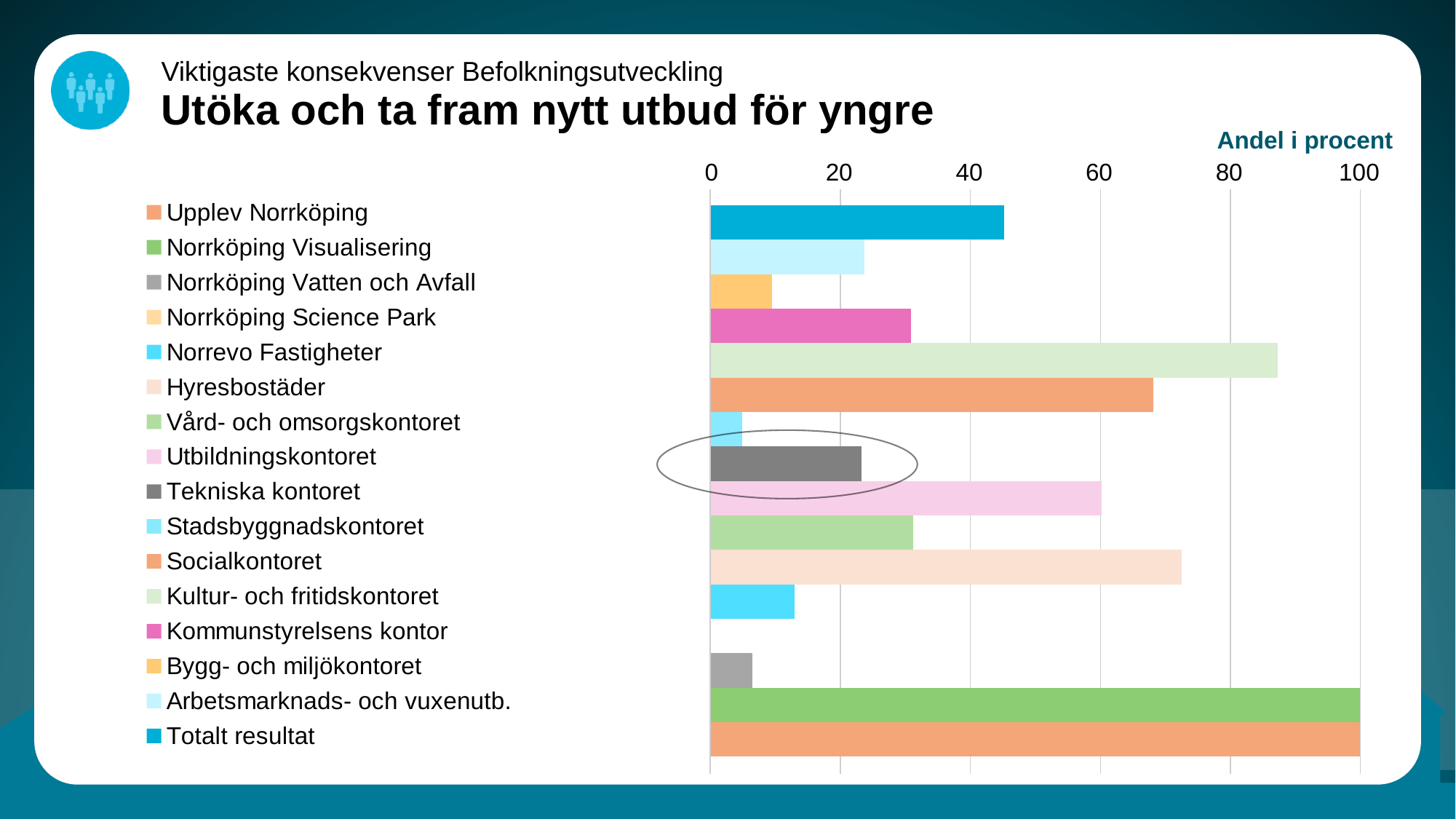
What label is shown above the horizontal axis of the chart? Andel i procent Is the value for Norrevo Fastigheter greater or less than 20? less Which is larger, the value for Kultur- och fritidskontoret or the value for Socialkontoret? Kultur- och fritidskontoret Is the value for Hyresbostäder greater or less than 60? greater Is the value for Totalt resultat greater or less than 40? greater Which is larger, the value for Totalt resultat or the value for Arbetsmarknads- och vuxenutb.? Totalt resultat How many entries does the legend list? 16 What kind of chart is shown on the slide? bar chart What is the value for Norrköping Visualisering? 100 What is the value for Upplev Norrköping? 100